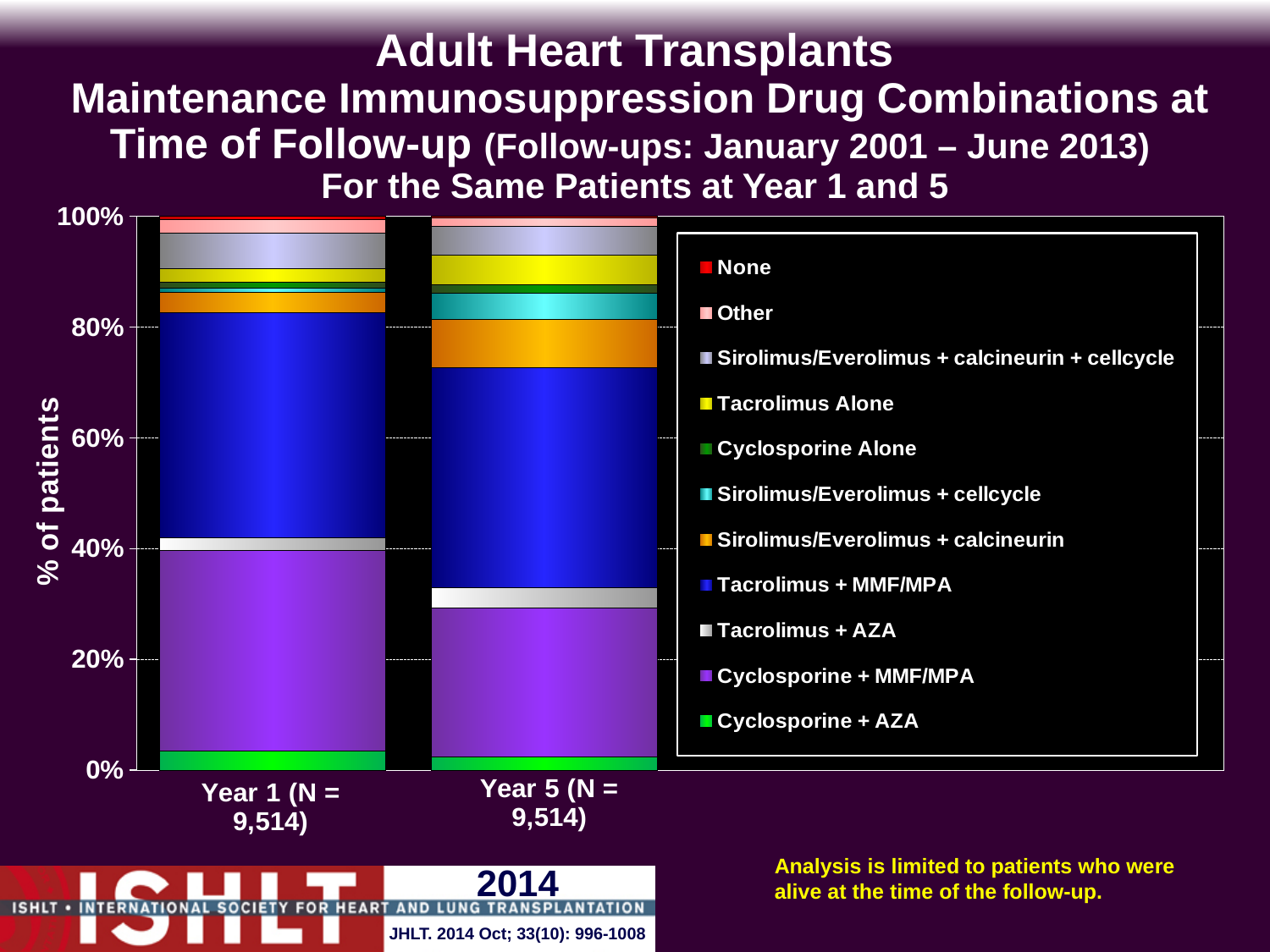
What is the N shown for the Year 5 bar? 9,514 Which bar has the larger Sirolimus/Everolimus + calcineurin segment, Year 1 or Year 5? Year 5 Is the Tacrolimus + MMF/MPA share of patients in the Year 5 bar greater or less than 20%? greater What kind of chart is shown on the slide? stacked bar chart How many bars (categories) are plotted on the x axis? 2 Is the Cyclosporine + MMF/MPA share of patients in the Year 1 bar greater or less than 20%? greater Which bar has the larger Cyclosporine + MMF/MPA segment, Year 1 or Year 5? Year 1 What is the label of the y axis? % of patients Does the Cyclosporine + MMF/MPA share of patients rise or fall from Year 1 to Year 5? fall How many series does the legend list? 11 Which legend entry is shown in red? None